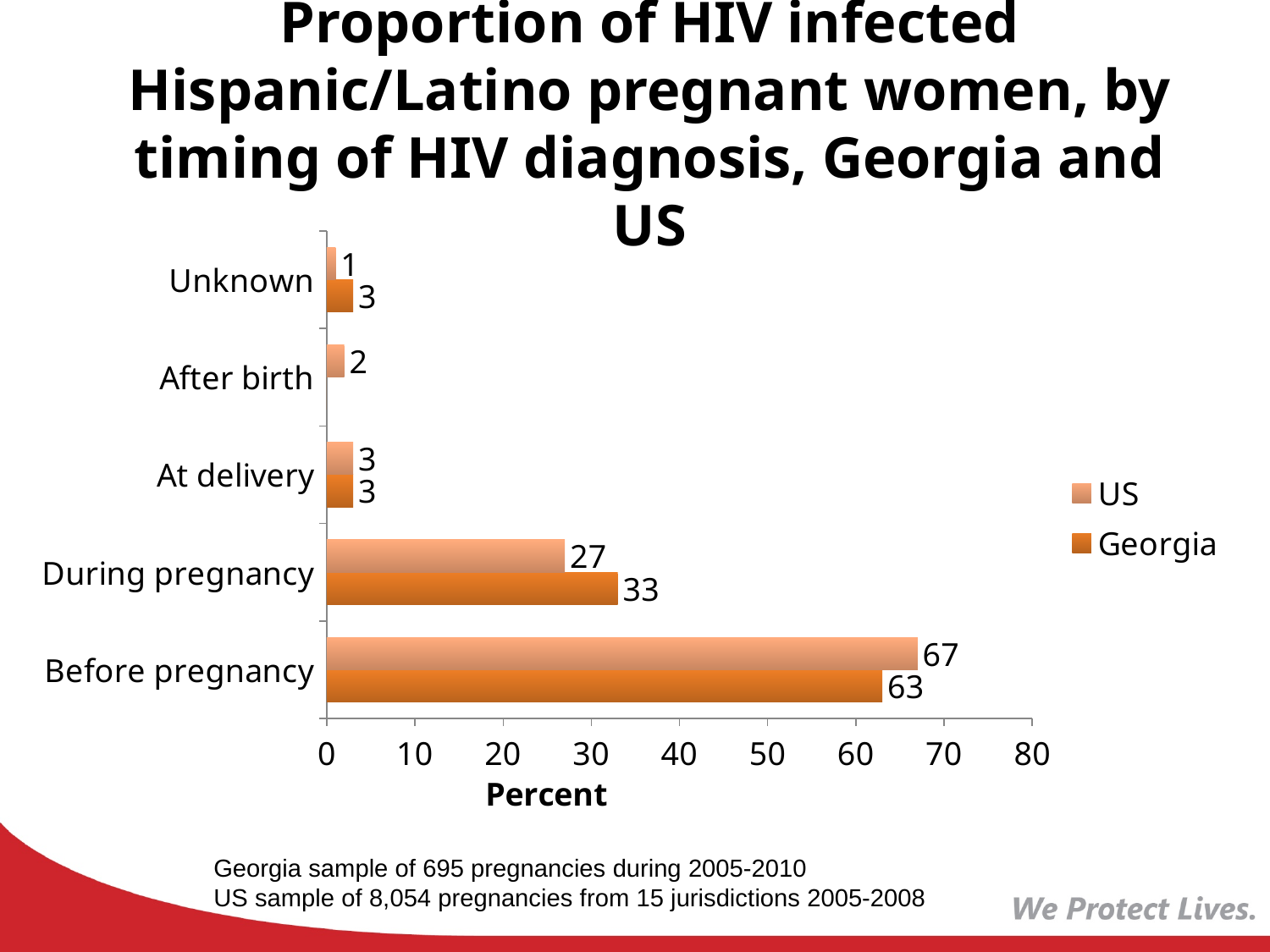
What is the Georgia value for During pregnancy? 33 What is the US value for After birth? 2 What is the difference between the US and Georgia values for During pregnancy? 6 What is the US value for Unknown? 1 How many series does the legend list? 2 Is the Georgia value for Before pregnancy greater or less than 60? greater What kind of chart is shown on the slide? Bar chart How many categories are shown on the y axis? 5 Which category has the highest Georgia value? Before pregnancy What is the US value for Before pregnancy? 67 Which category has the lowest US value? Unknown Which is larger for Before pregnancy, the US value or the Georgia value? US